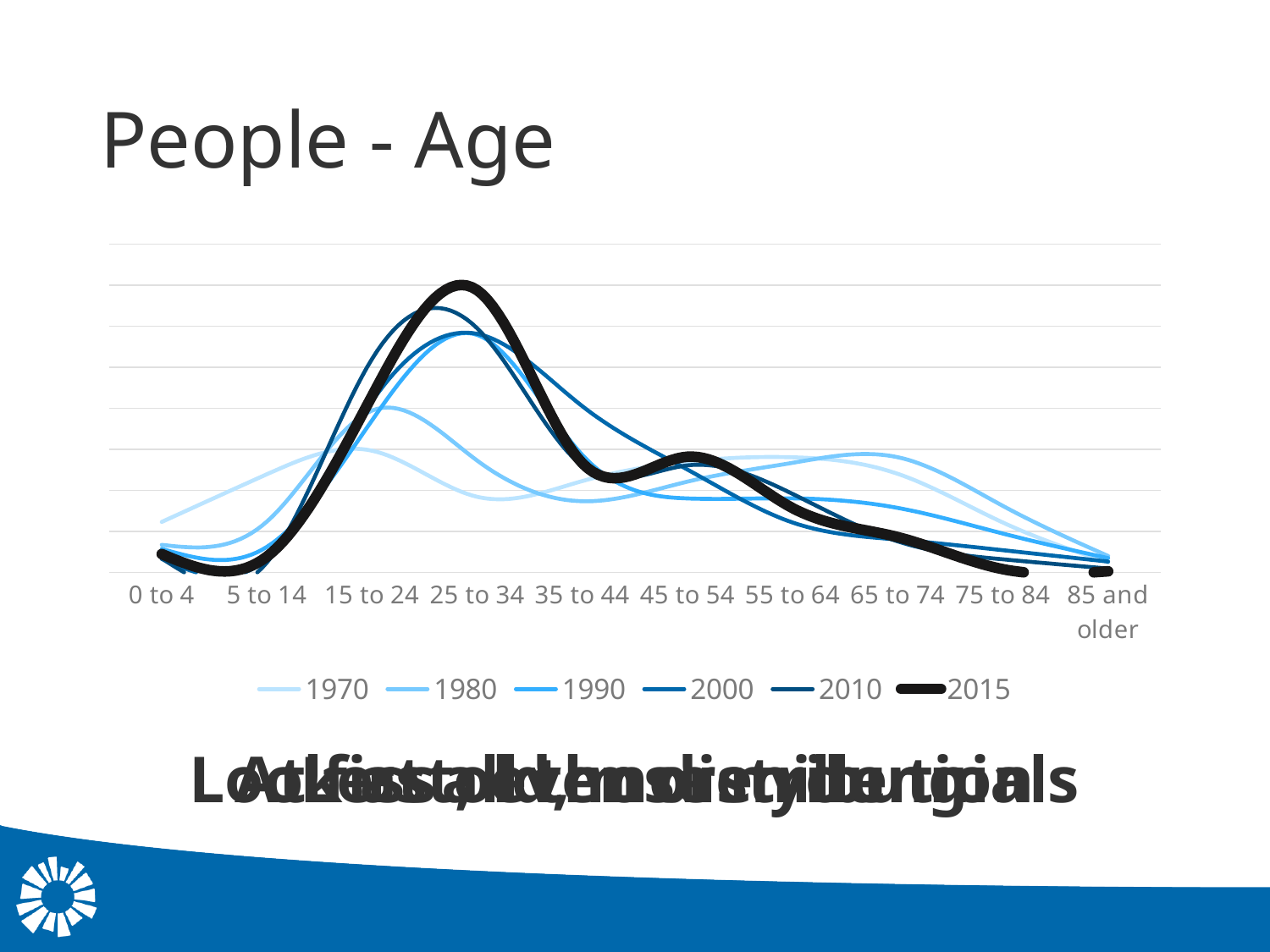
What kind of chart is shown on the slide? line chart At the 25 to 34 age group, which series has the lowest value? 1970 At the 0 to 4 age group, which series has the larger value: 1970 or 2015? 1970 How many age categories are shown on the x axis? 10 Which series is drawn as the thick black line? 2015 What is the title of the slide containing the chart? People - Age For the 2015 series, which is larger: the value for 25 to 34 or the value for 45 to 54? 25 to 34 For the 2015 series, which age group has the highest value? 25 to 34 For the 1980 series, which age group has the highest value? 15 to 24 At the 25 to 34 age group, which series has the highest value? 2015 How many series does the legend list? 6